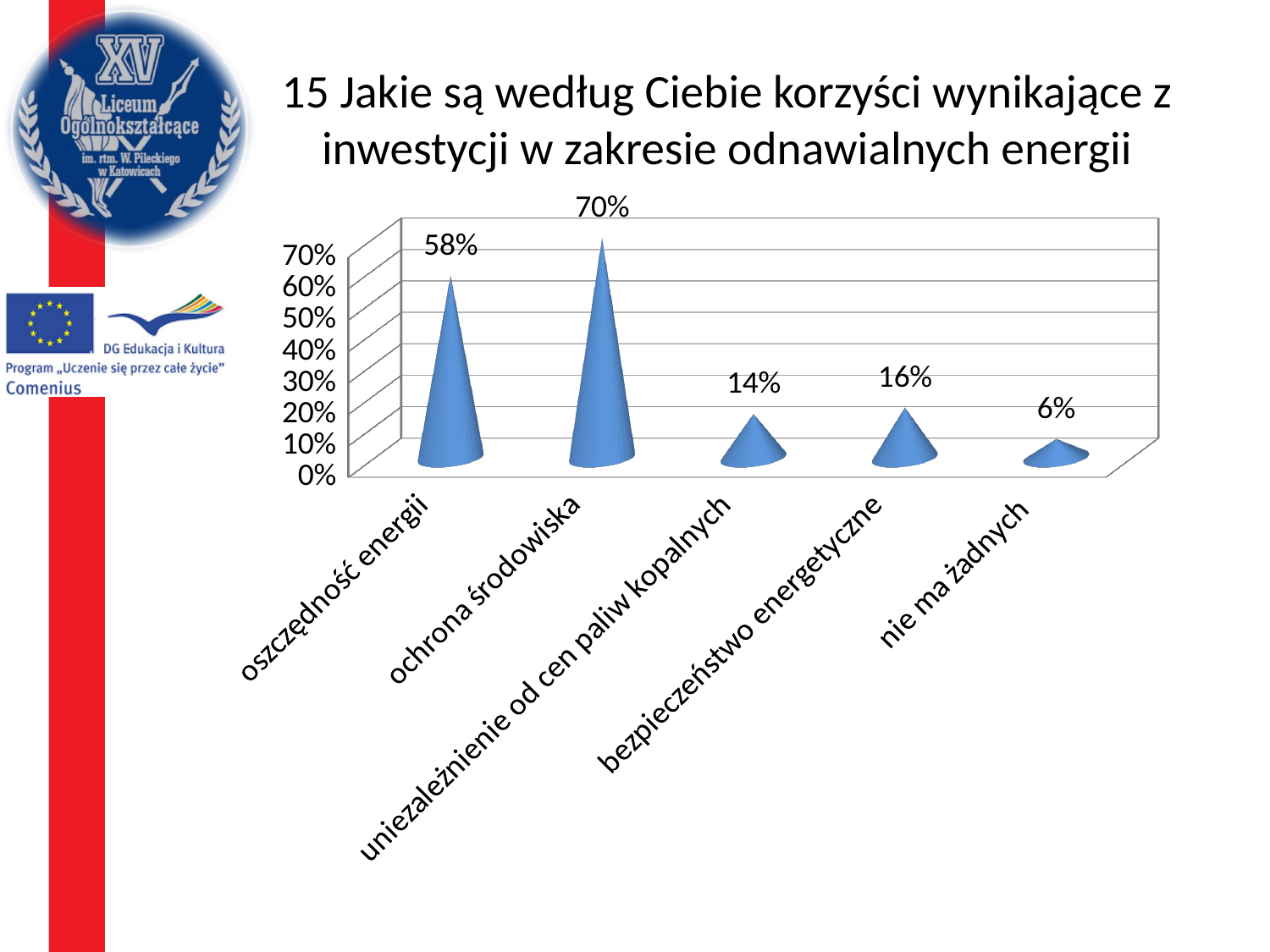
Which category has the highest value? ochrona środowiska What kind of chart is shown on the slide? bar chart What is the difference between the values for "ochrona środowiska" and "oszczędność energii"? 12% What is the value for "uniezależnienie od cen paliw kopalnych"? 14% What is the value for "bezpieczeństwo energetyczne"? 16% Which is larger, the value for "bezpieczeństwo energetyczne" or "uniezależnienie od cen paliw kopalnych"? bezpieczeństwo energetyczne How many categories are shown on the chart? 5 What is the value for "oszczędność energii"? 58% What is the title of the chart on the slide? 15 Jakie są według Ciebie korzyści wynikające z inwestycji w zakresie odnawialnych energii What is the value for "nie ma żadnych"? 6% What is the value for "ochrona środowiska"? 70% Which category has the lowest value? nie ma żadnych